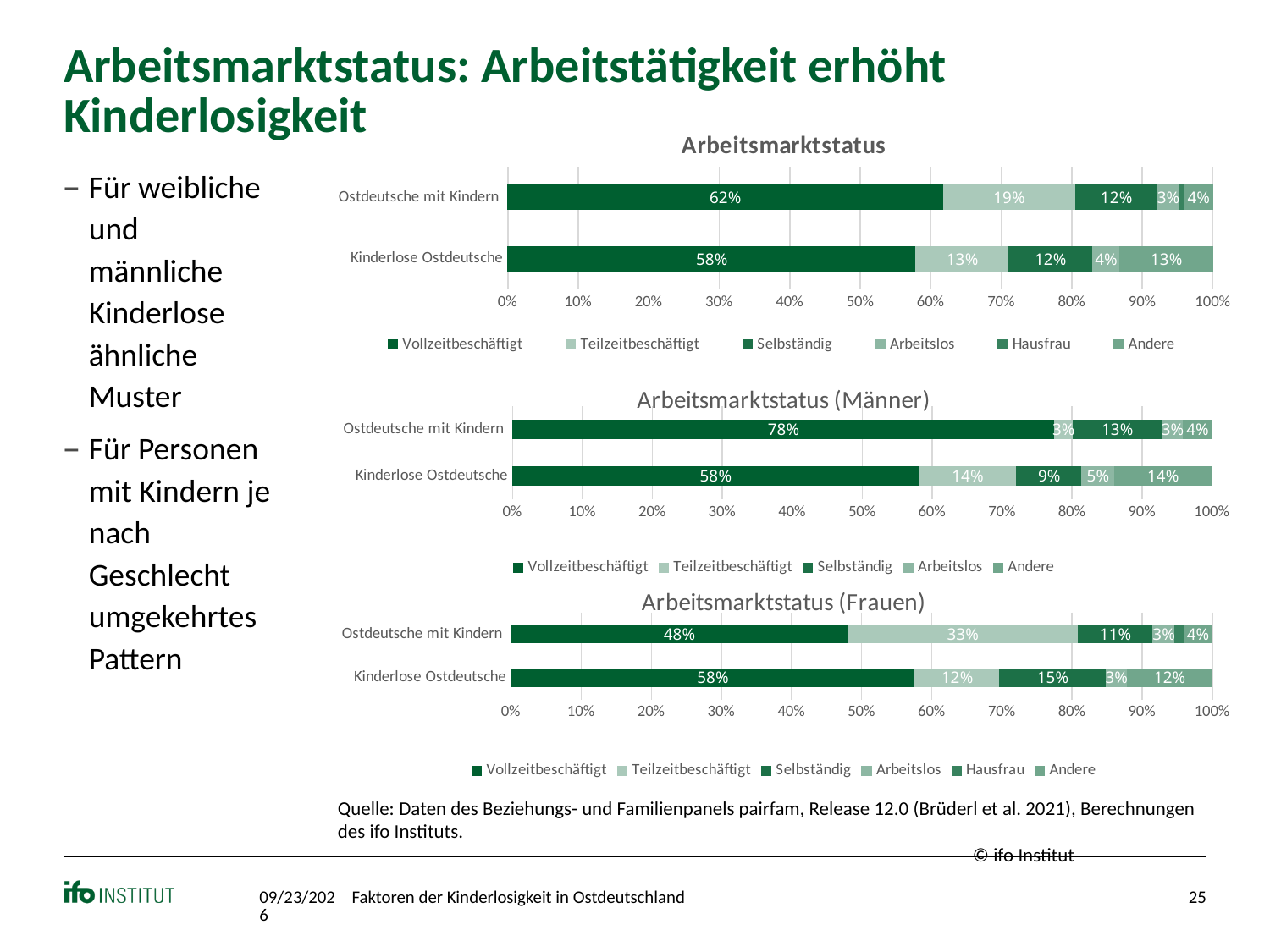
In the chart titled "Arbeitsmarktstatus (Frauen)", which category has the larger Vollzeitbeschäftigt value, Ostdeutsche mit Kindern or Kinderlose Ostdeutsche? Kinderlose Ostdeutsche In the chart titled "Arbeitsmarktstatus (Männer)", what is the Vollzeitbeschäftigt value for Ostdeutsche mit Kindern? 78% What kind of chart is the chart titled "Arbeitsmarktstatus"? Stacked bar chart In the chart titled "Arbeitsmarktstatus (Männer)", what is the difference between the Vollzeitbeschäftigt values for Ostdeutsche mit Kindern and Kinderlose Ostdeutsche? 20% In the chart titled "Arbeitsmarktstatus (Frauen)", what is the Selbständig value for Kinderlose Ostdeutsche? 15% In the chart titled "Arbeitsmarktstatus", what is the Vollzeitbeschäftigt value for Ostdeutsche mit Kindern? 62% How many series does the legend of the chart titled "Arbeitsmarktstatus (Frauen)" list? 6 How many series does the legend of the chart titled "Arbeitsmarktstatus (Männer)" list? 5 How many categories are shown on the y axis of the chart titled "Arbeitsmarktstatus (Frauen)"? 2 In the chart titled "Arbeitsmarktstatus", what is the Teilzeitbeschäftigt value for Kinderlose Ostdeutsche? 13% In the chart titled "Arbeitsmarktstatus (Frauen)", what is the Teilzeitbeschäftigt value for Ostdeutsche mit Kindern? 33% In the chart titled "Arbeitsmarktstatus", which category has the larger Teilzeitbeschäftigt value, Ostdeutsche mit Kindern or Kinderlose Ostdeutsche? Ostdeutsche mit Kindern